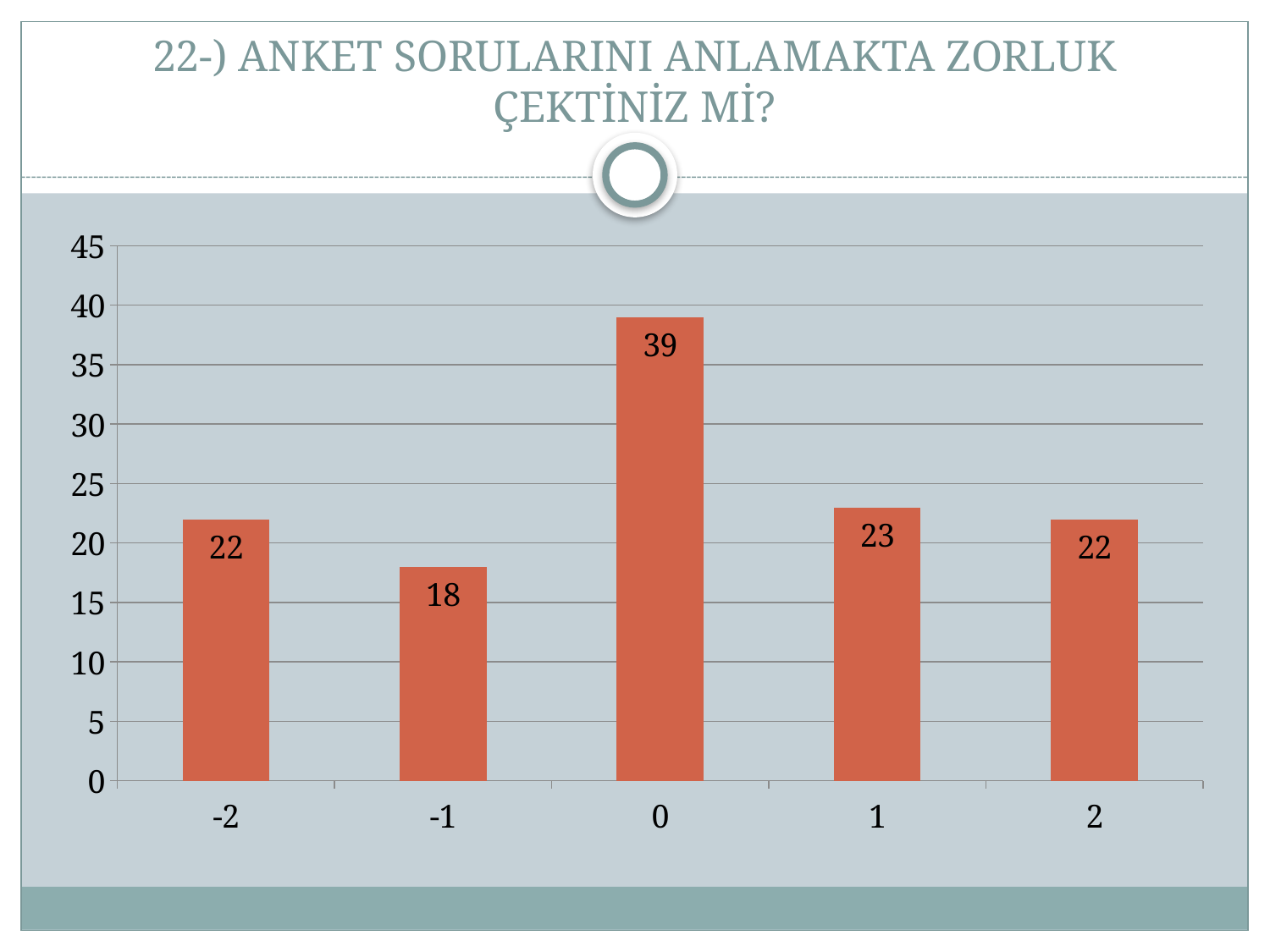
What is the difference between the values for category 0 and category -1? 21 What is the value for category -1? 18 How many categories are shown on the x axis? 5 What is the title of the slide? 22-) ANKET SORULARINI ANLAMAKTA ZORLUK ÇEKTİNİZ Mİ? What kind of chart is shown on the slide? bar chart What is the value for category 0? 39 Which category has the highest value? 0 What is the value for category 1? 23 Which is larger, the value for category 1 or the value for category -1? 1 Is the value for category 0 greater or less than 35? greater What is the value for category 2? 22 Which category has the lowest value? -1